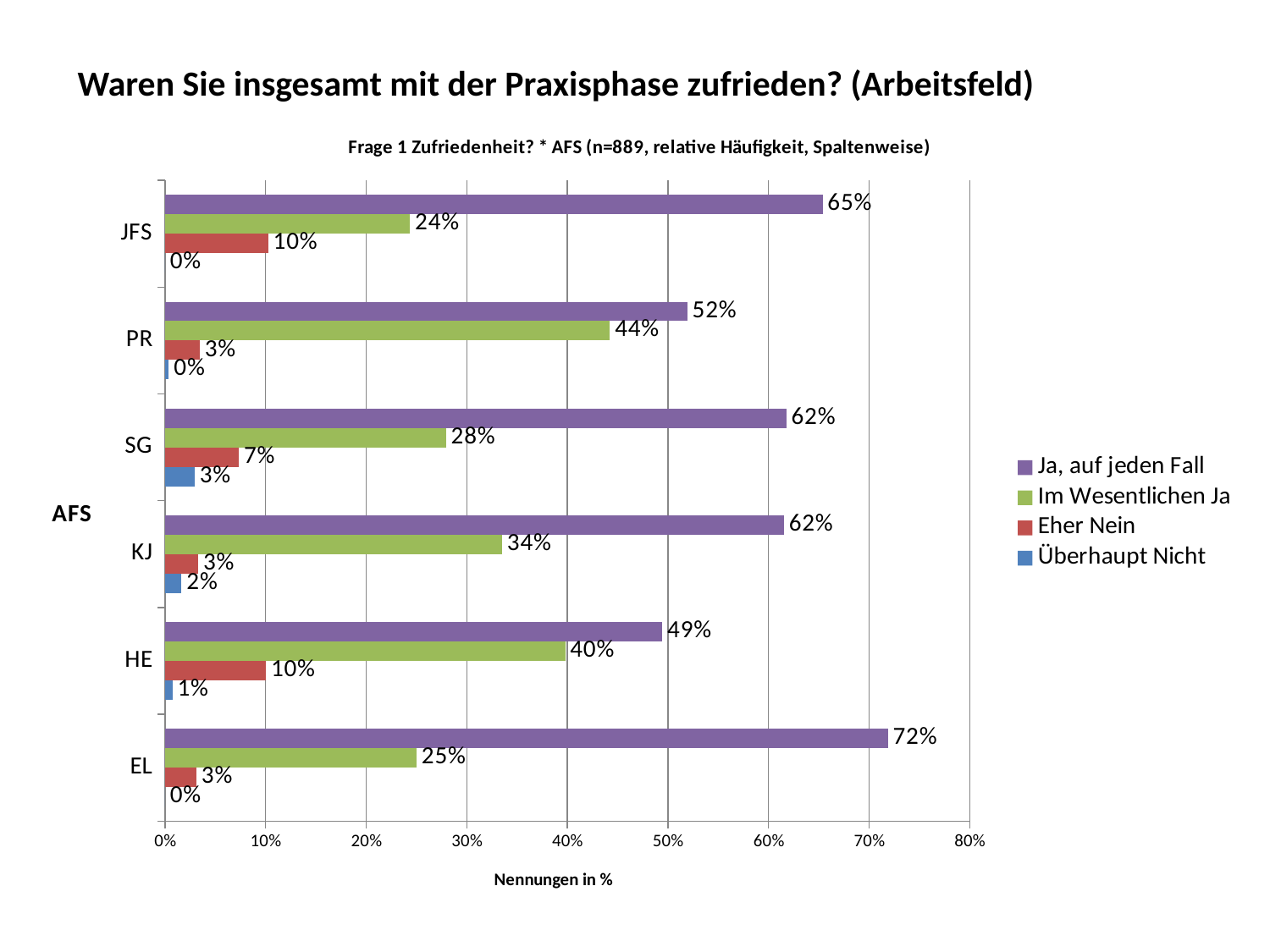
What is the label of the horizontal axis? Nennungen in % Which category has the lowest value for "Ja, auf jeden Fall"? HE What kind of chart is shown on the slide? bar chart Which category has the highest value for "Ja, auf jeden Fall"? EL How many categories are shown on the vertical axis? 6 Is the value for "Ja, auf jeden Fall" in the SG category greater or less than 50%? greater Which is larger: the "Im Wesentlichen Ja" value for KJ or for SG? KJ What is the difference between the "Ja, auf jeden Fall" values for JFS and PR? 13% How many series does the legend list? 4 What is the value for "Ja, auf jeden Fall" in the EL category? 72% What is the value for "Eher Nein" in the HE category? 10% What is the value for "Im Wesentlichen Ja" in the PR category? 44%